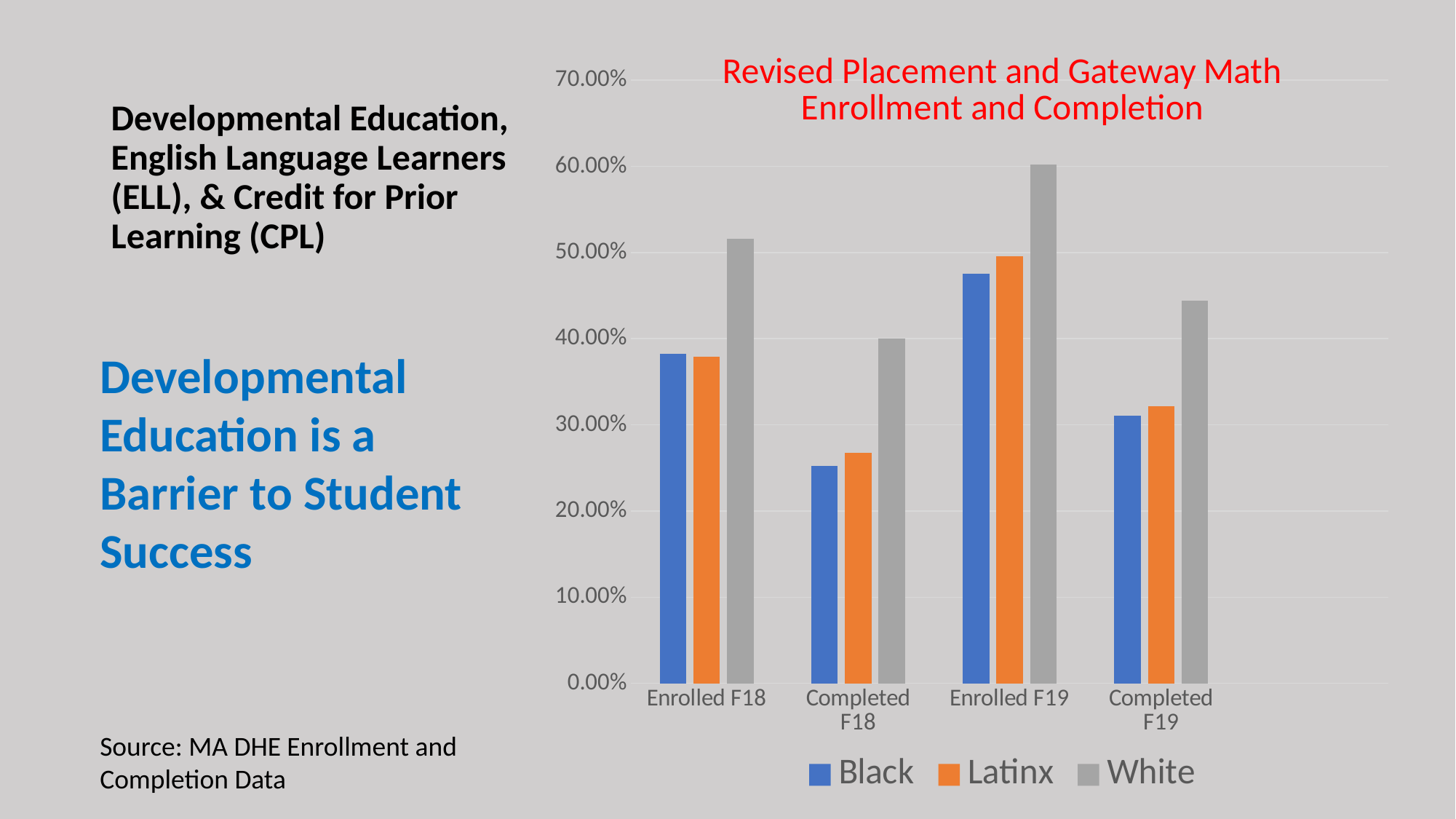
Which group has the lowest value for Completed F18? Black What kind of chart is shown on the slide? bar chart What is the title of the chart? Revised Placement and Gateway Math Enrollment and Completion Is the value for Black in Completed F18 greater or less than 30.00%? less Is the value for White in Completed F19 greater or less than 40.00%? greater Which is larger for Completed F19: the value for White or the value for Black? White How many categories are shown on the x axis of the chart? 4 How many series does the chart's legend list? 3 Which colour represents the Latinx series in the chart? orange Which group has the highest value for Enrolled F19? White Is the value for White in Enrolled F19 greater or less than 50.00%? greater